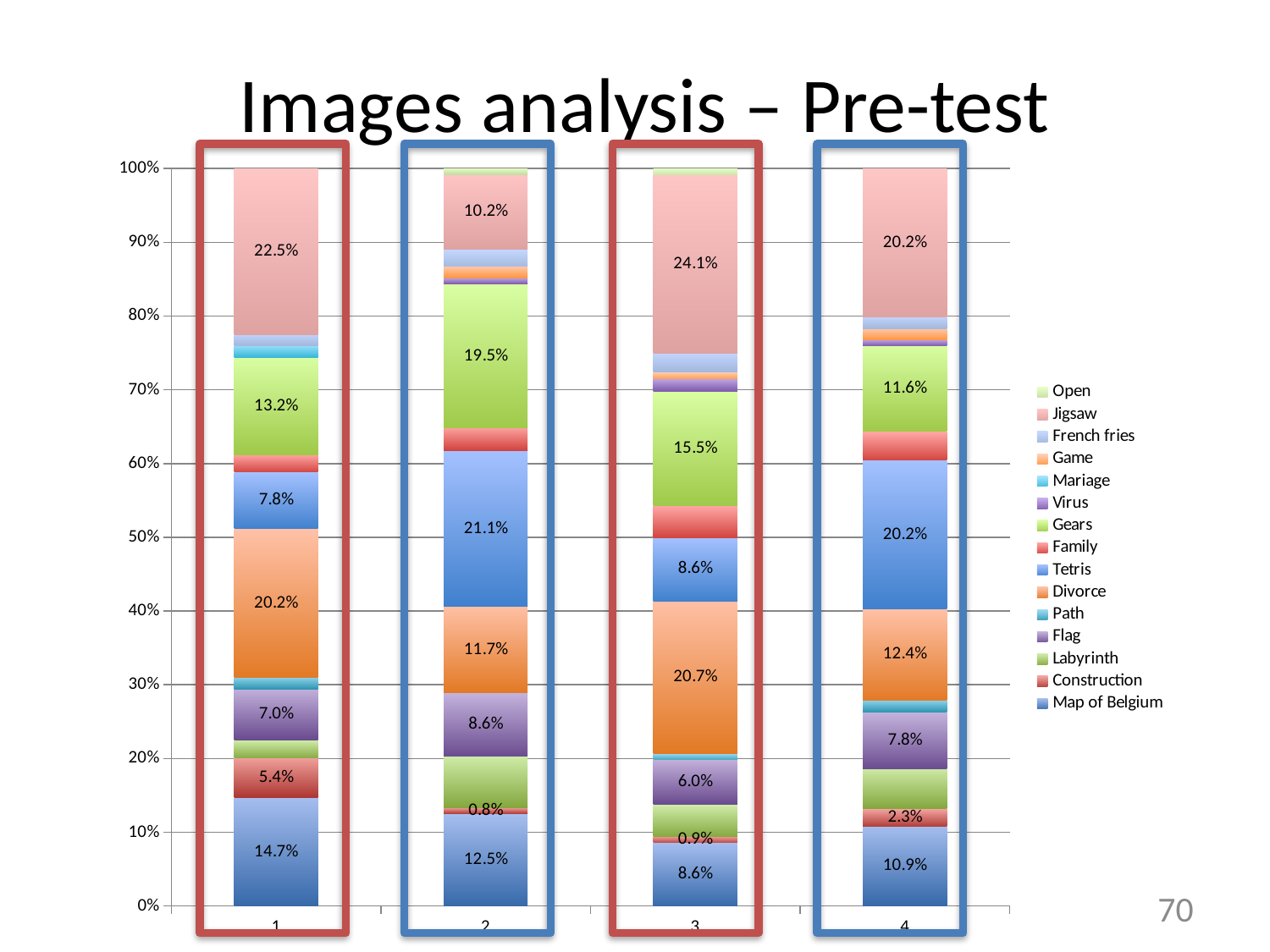
How many series does the legend list? 15 What is the difference between the Gears share for category 2 and for category 1? 6.3% Which is larger, the Divorce share for category 1 or for category 4? category 1 What is the Divorce share for category 3? 20.7% What kind of chart is shown on the slide? stacked bar chart What is the Construction share for category 2? 0.8% What is the Tetris share for category 2? 21.1% How many categories are shown on the x axis? 4 What is the Jigsaw share for category 1? 22.5% Which category has the lowest Construction share? 2 What is the Map of Belgium share for category 4? 10.9% Which category has the highest Jigsaw share? 3